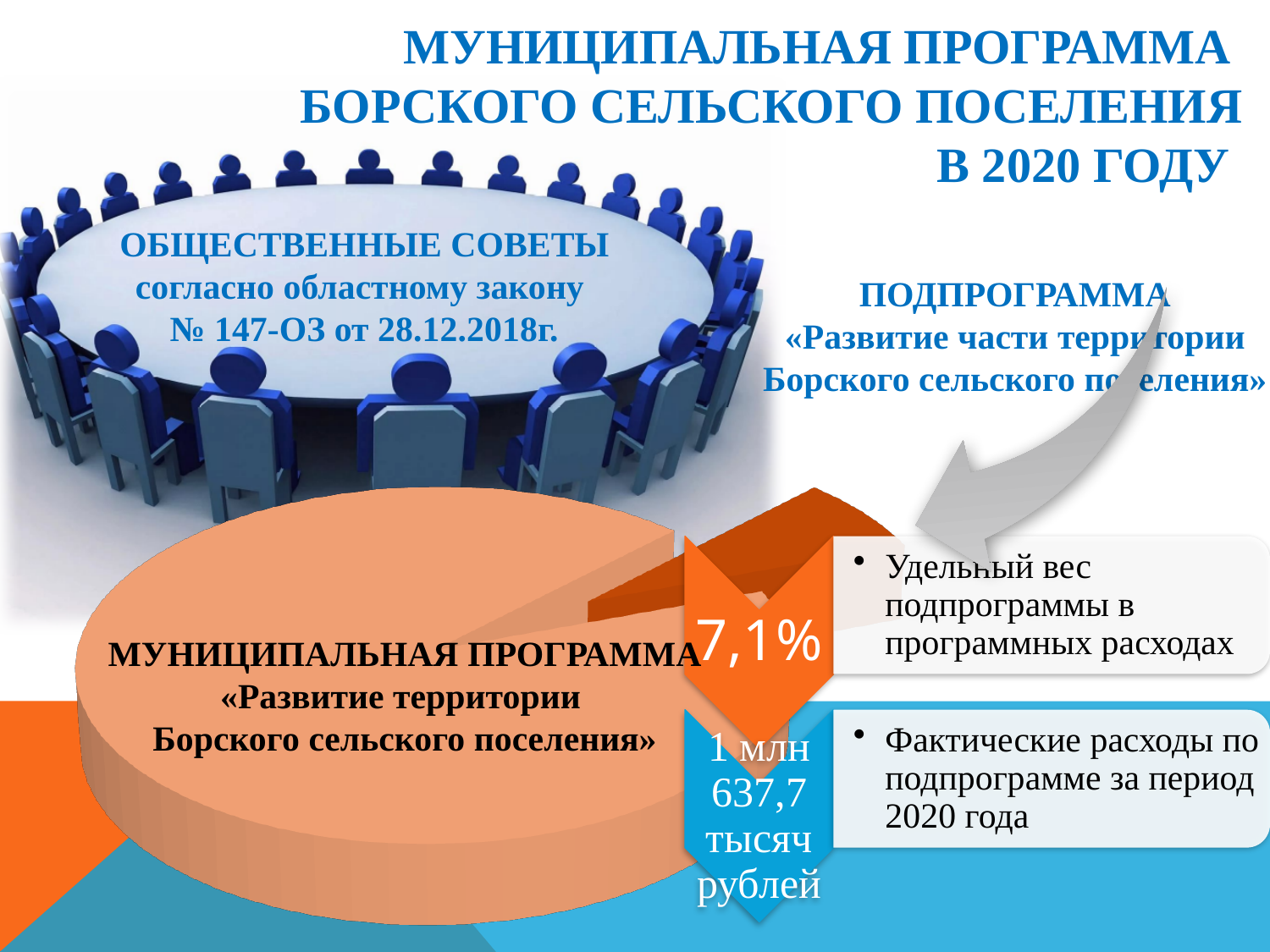
What kind of chart is shown on the slide? Pie chart What colour is the exploded slice labelled 7,1%? Orange Is the share of the exploded orange slice greater or less than 10%? less What share of the pie does the exploded orange slice (the subprogram «Развитие части территории Борского сельского поселения») represent? 7,1% What are the actual expenditures on the subprogram for 2020 shown next to the pie chart? 1 млн 637,7 тысяч рублей What does the 7,1% value on the pie chart represent, according to the callout next to it? Удельный вес подпрограммы в программных расходах Which slice of the pie chart is the smallest? The 7,1% slice (the subprogram) Which slice of the pie is larger: the one labelled «МУНИЦИПАЛЬНАЯ ПРОГРАММА «Развитие территории Борского сельского поселения»» or the one labelled 7,1%? МУНИЦИПАЛЬНАЯ ПРОГРАММА «Развитие территории Борского сельского поселения» How many slices does the pie chart have? 2